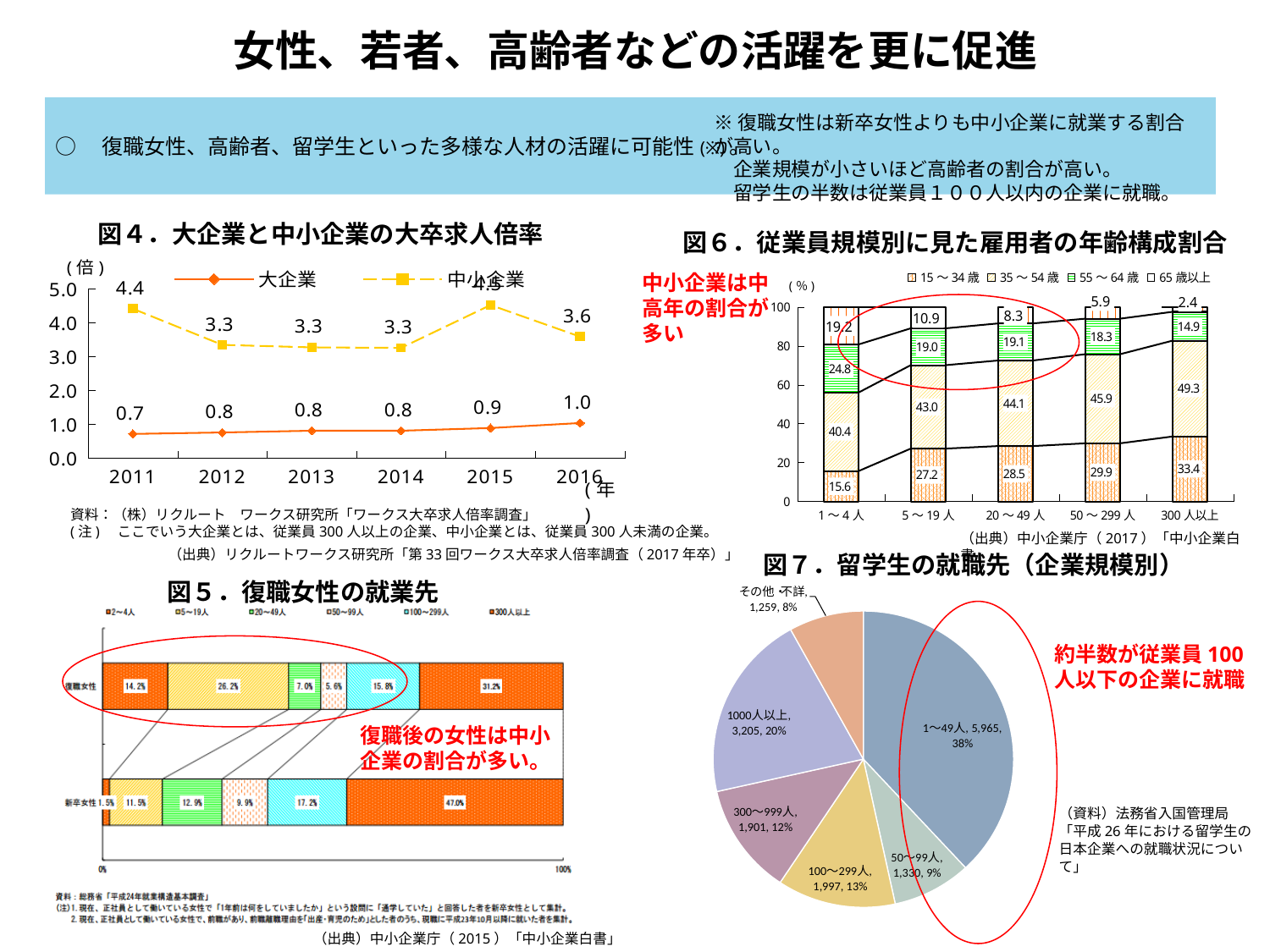
In 図6 (従業員規模別に見た雇用者の年齢構成割合), which employee-size category has the highest value for 15～34歳? 300人以上 In 図4 (大企業と中小企業の大卒求人倍率), what is the difference between 中小企業 and 大企業 in 2016? 2.6 In 図7 (留学生の就職先（企業規模別）), what share of the pie is 1～49人? 38% In 図6 (従業員規模別に見た雇用者の年齢構成割合), how many series does the legend list? 4 In 図6 (従業員規模別に見た雇用者の年齢構成割合), what is the value for 65歳以上 in the 1～4人 category? 19.2 In 図6 (従業員規模別に見た雇用者の年齢構成割合), which is larger: 35～54歳 for 5～19人 or 35～54歳 for 300人以上? 300人以上 In 図7 (留学生の就職先（企業規模別）), what is the value for 1000人以上? 3,205 In 図4 (大企業と中小企業の大卒求人倍率), how many years are plotted on the x axis? 6 In 図5 (復職女性の就業先), what is the value for 300人以上 in the 新卒女性 bar? 47.0% In 図4 (大企業と中小企業の大卒求人倍率), what is the value for 中小企業 in 2011? 4.4 In 図4 (大企業と中小企業の大卒求人倍率), what is the value for 大企業 in 2016? 1.0 In 図4 (大企業と中小企業の大卒求人倍率), what kind of chart is shown? Line chart